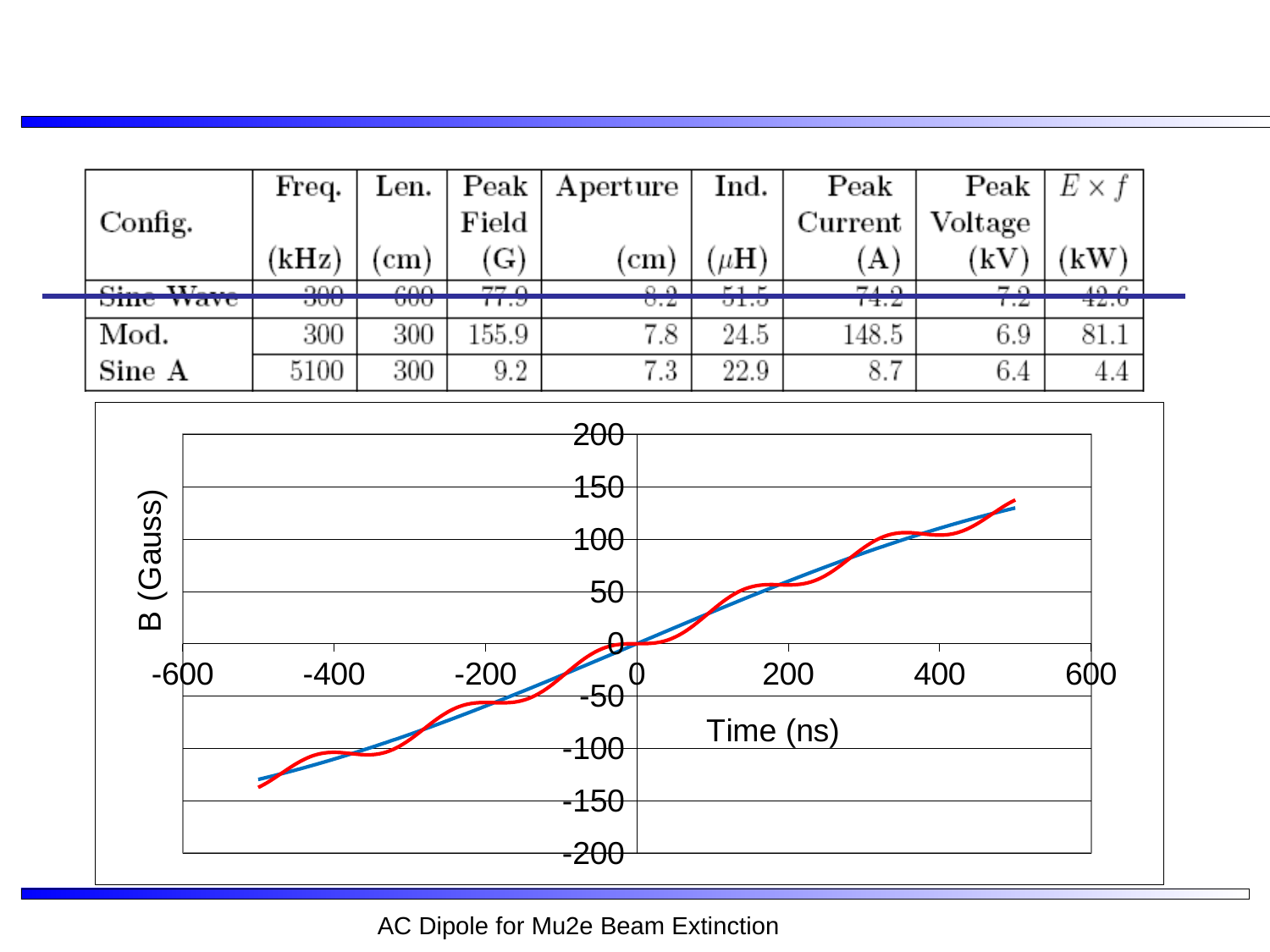
How many lines are plotted on the chart? 2 Which line has the larger value at time -400 ns, the red line or the blue line? red line What is the label of the x axis? Time (ns) What kind of chart is shown on the slide? line chart Do the plotted values rise or fall as time increases along the x axis? rise Is the value of the blue line at time 400 ns greater or less than 50? greater Is the value of the blue line at time 200 ns greater or less than 100? less What colour is the wavy (oscillating) line on the chart? red Is the value of the red line at time -200 ns greater or less than -100? greater What is the value of B (Gauss) at time 0 ns? 0